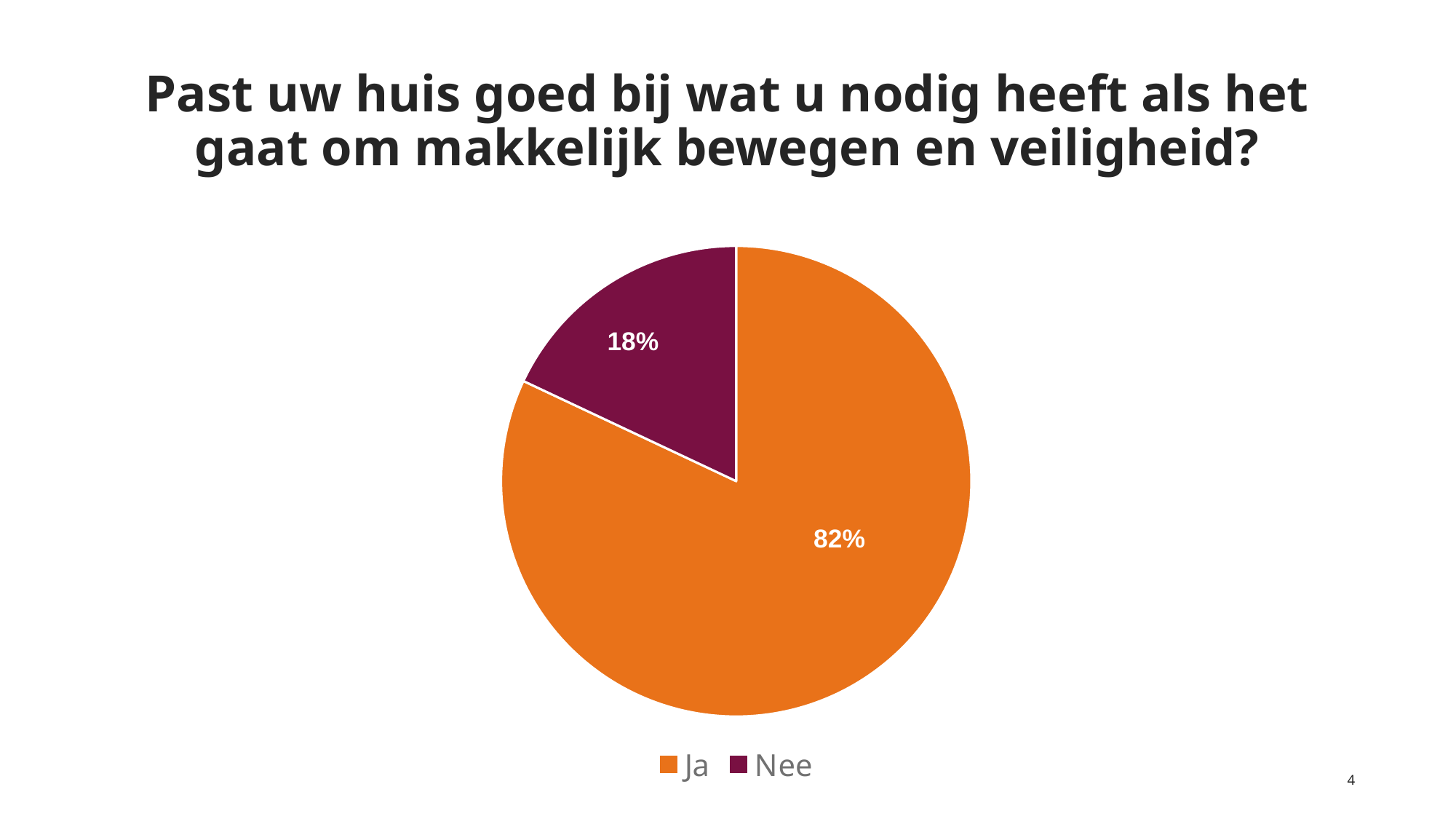
What is the title of the chart? Past uw huis goed bij wat u nodig heeft als het gaat om makkelijk bewegen en veiligheid? How many slices does the pie chart have? 2 What share of the pie does "Ja" represent? 82% Which slice is the largest? Ja How many entries does the legend list? 2 What is the difference in percentage points between the "Ja" and "Nee" slices? 64 What kind of chart is shown on the slide? pie chart What share of the pie does "Nee" represent? 18% Which is larger, the "Ja" slice or the "Nee" slice? Ja Which slice is the smallest? Nee What colour is the "Nee" slice? purple